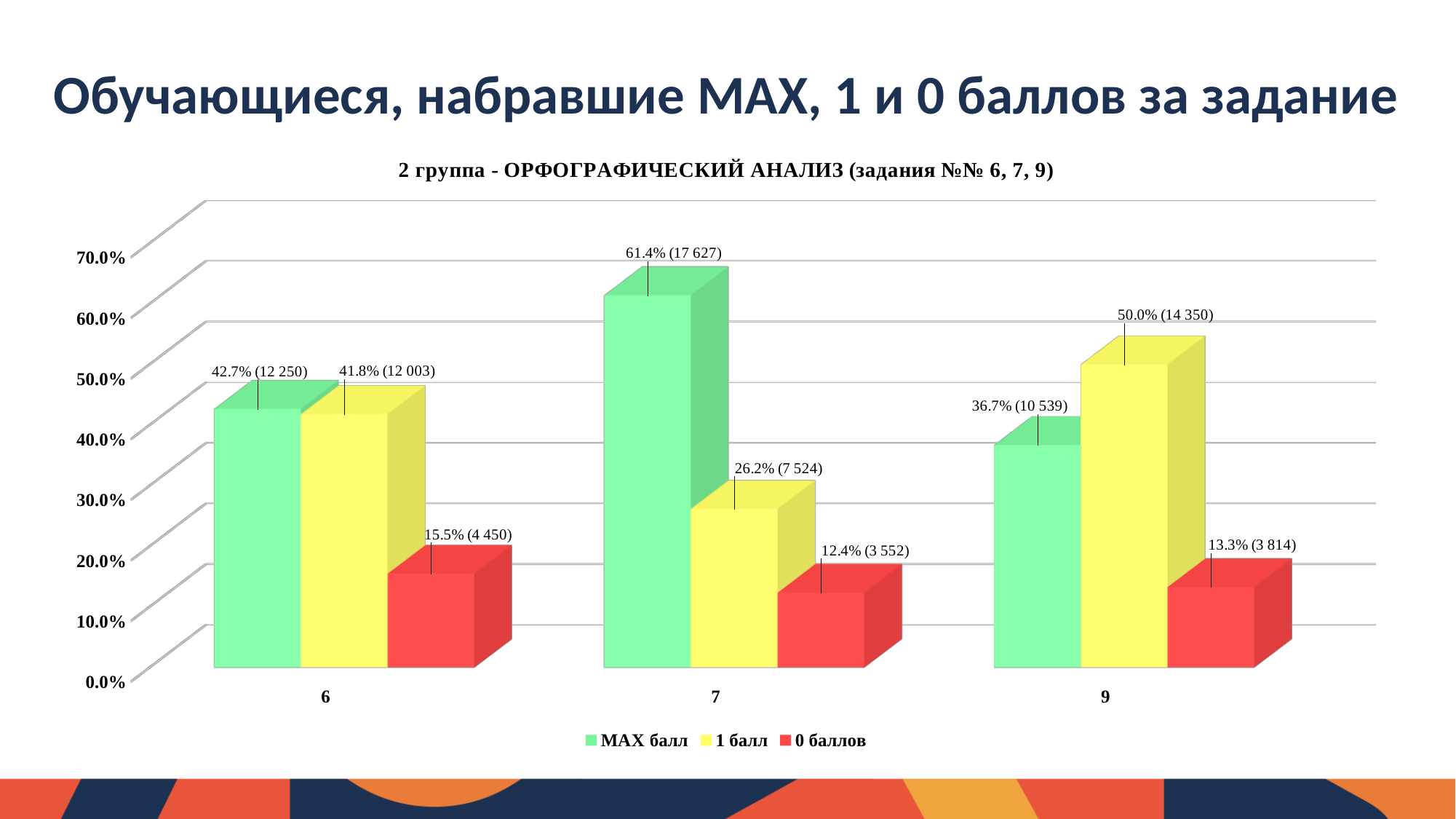
Is the value for 0 баллов for task 6 greater or less than 20%? less What is the value for MAX балл for task 6? 42.7% (12 250) How many series does the legend list? 3 Which task has the lowest value for 0 баллов? 7 What is the value for 0 баллов for task 7? 12.4% (3 552) How many tasks (categories) are shown on the x axis? 3 Which task has the highest value for MAX балл? 7 What is the value for 1 балл for task 9? 50.0% (14 350) For task 6, which is larger: MAX балл or 1 балл? MAX балл What is the difference in percentage between MAX балл and 1 балл for task 7? 35.2% What is the difference in percentage between 1 балл and MAX балл for task 9? 13.3% What kind of chart is shown on the slide? bar chart